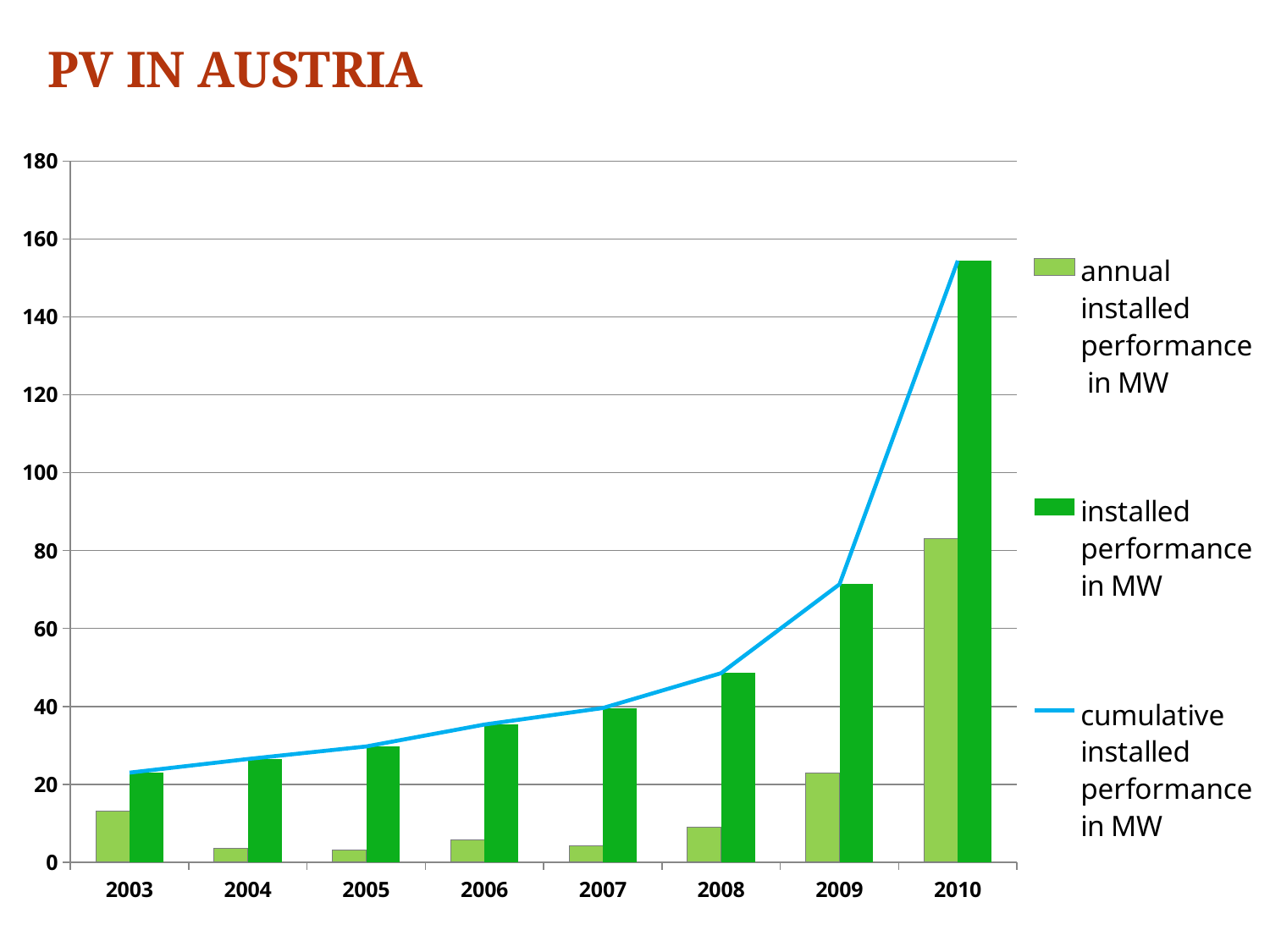
Is the annual installed performance in MW for 2009 greater or less than 40? less Which year has the highest annual installed performance in MW? 2010 How many years are shown on the x axis? 8 Is the installed performance in MW for 2010 greater or less than 140? greater What is the title of the slide? PV IN AUSTRIA Which is larger, the installed performance in MW for 2008 or for 2007? 2008 Which year has the lowest installed performance in MW? 2003 Is the installed performance in MW for 2003 greater or less than 40? less Does the cumulative installed performance in MW rise or fall from 2003 to 2010? rise What kind of chart is shown on the slide? bar chart with a line How many series does the legend list? 3